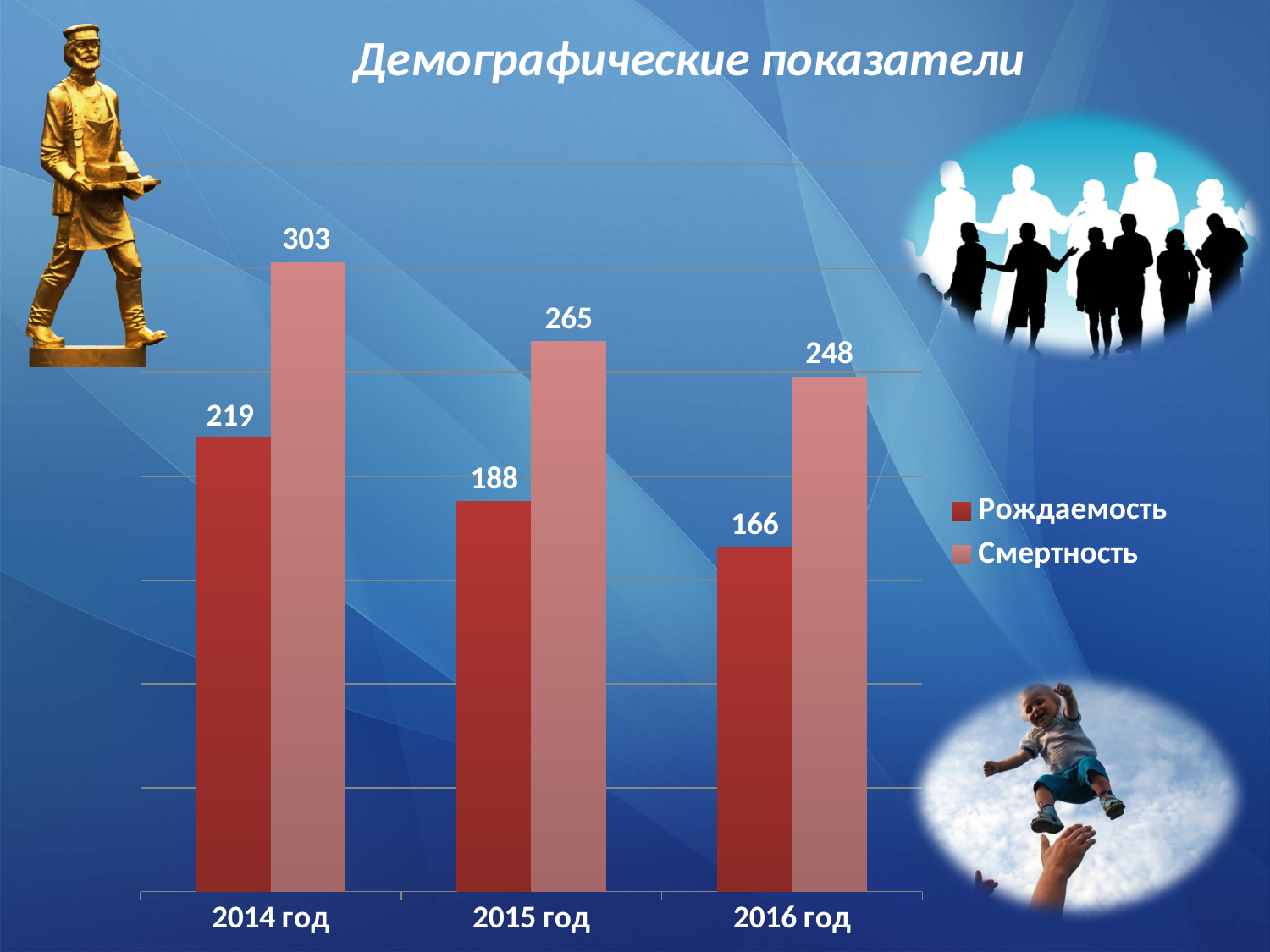
In which year is Смертность highest? 2014 год In which year is Рождаемость lowest? 2016 год What is the difference between Рождаемость in 2015 год and 2016 год? 22 What is the value of Смертность for 2016 год? 248 Which is larger in 2016 год, Рождаемость or Смертность? Смертность How many series does the legend list? 2 What kind of chart is shown on the slide? Bar chart What is the value of Рождаемость for 2014 год? 219 Does Смертность rise or fall from 2014 год to 2016 год? Fall How many years are shown on the x axis? 3 What is the difference between Смертность and Рождаемость in 2014 год? 84 What is the value of Смертность for 2015 год? 265